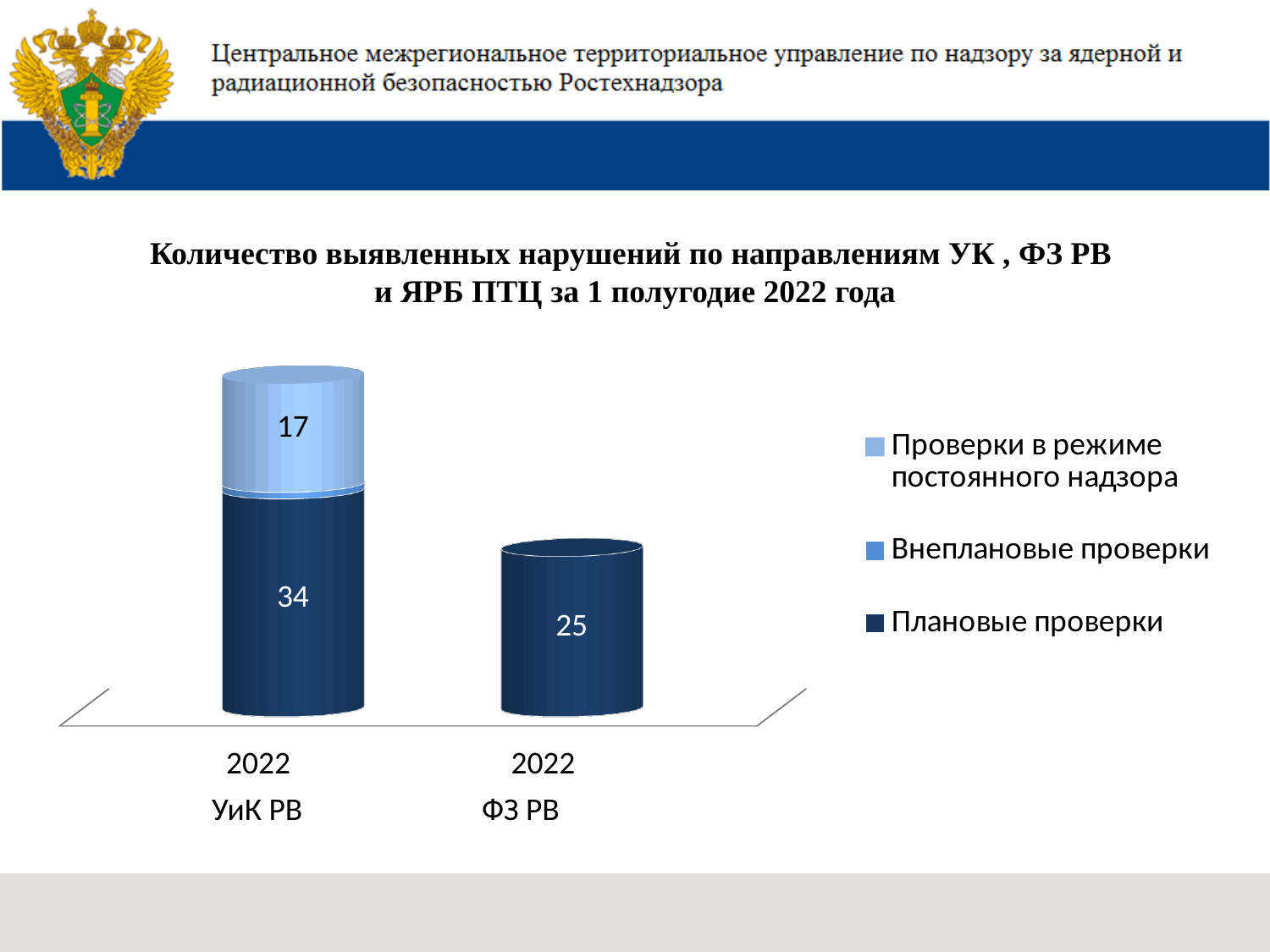
What is the difference between Плановые проверки for УиК РВ and for ФЗ РВ? 9 Which category has the higher value for Плановые проверки, УиК РВ or ФЗ РВ? УиК РВ What is the value of Плановые проверки for ФЗ РВ? 25 Which legend entry is listed last? Плановые проверки How many categories are shown on the x axis? 2 How many series does the legend list? 3 What is the difference between Плановые проверки and Проверки в режиме постоянного надзора for УиК РВ? 17 What is the value of Проверки в режиме постоянного надзора for УиК РВ? 17 Which category has the tallest stacked bar overall? УиК РВ What is the value of Плановые проверки for УиК РВ? 34 What type of chart is shown on the slide? Stacked bar chart